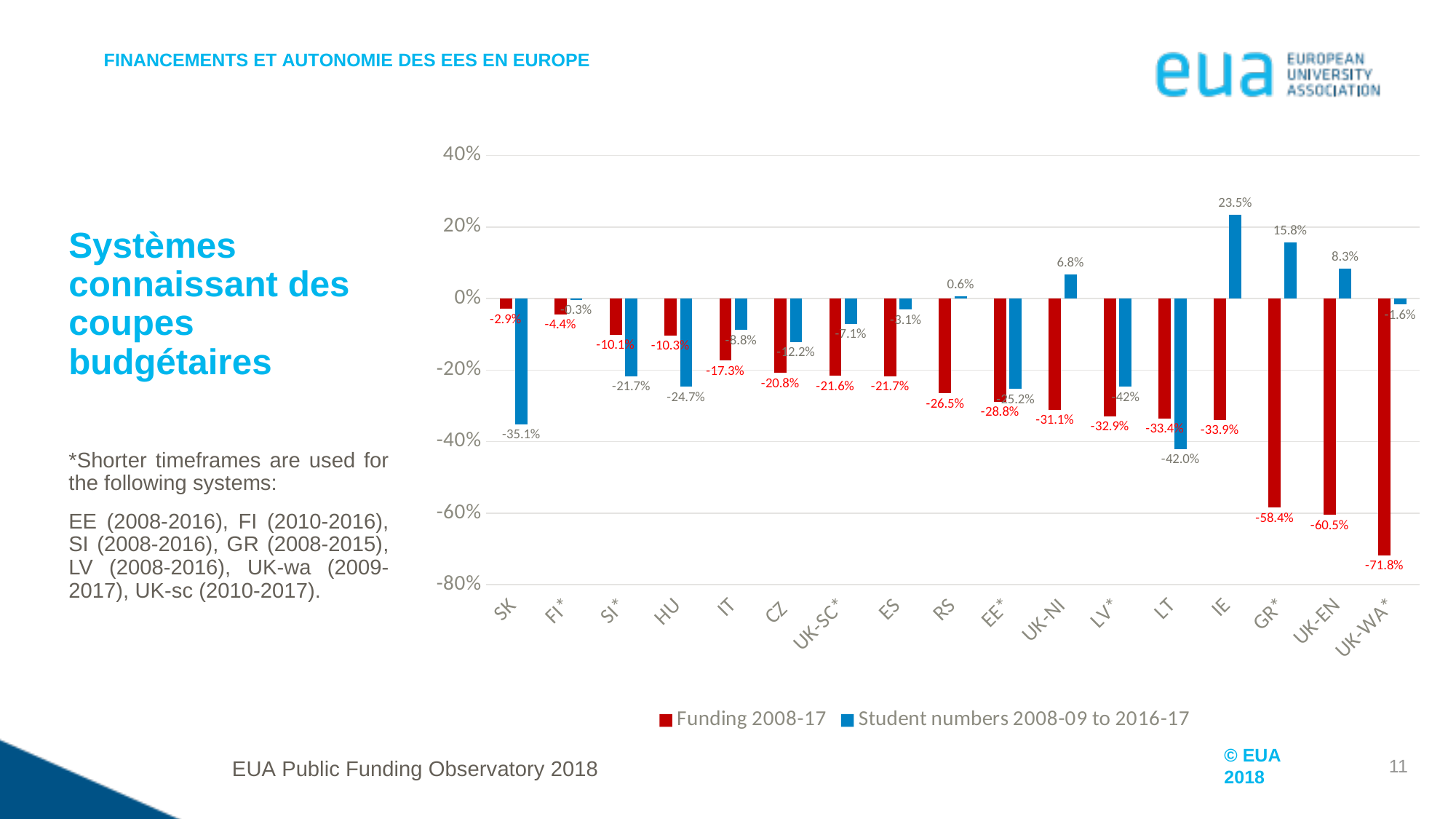
Which system has the lowest Funding 2008-17 value? UK-WA* What is the Student numbers 2008-09 to 2016-17 value for IE? 23.5% Is the Funding 2008-17 value for LT greater or less than -20%? less Which system has the highest Student numbers 2008-09 to 2016-17 value? IE Which has the lower Student numbers 2008-09 to 2016-17 value, SK or LT? LT What is the Funding 2008-17 value for UK-WA*? -71.8% What colour represents the Funding 2008-17 series in the chart? red How many series does the legend list? 2 How many systems are shown on the x axis of the chart? 17 What is the Funding 2008-17 value for RS? -26.5% What kind of chart is shown on the slide? bar chart What is the difference between the Funding 2008-17 values for GR* (-58.4%) and UK-EN (-60.5%)? 2.1 percentage points